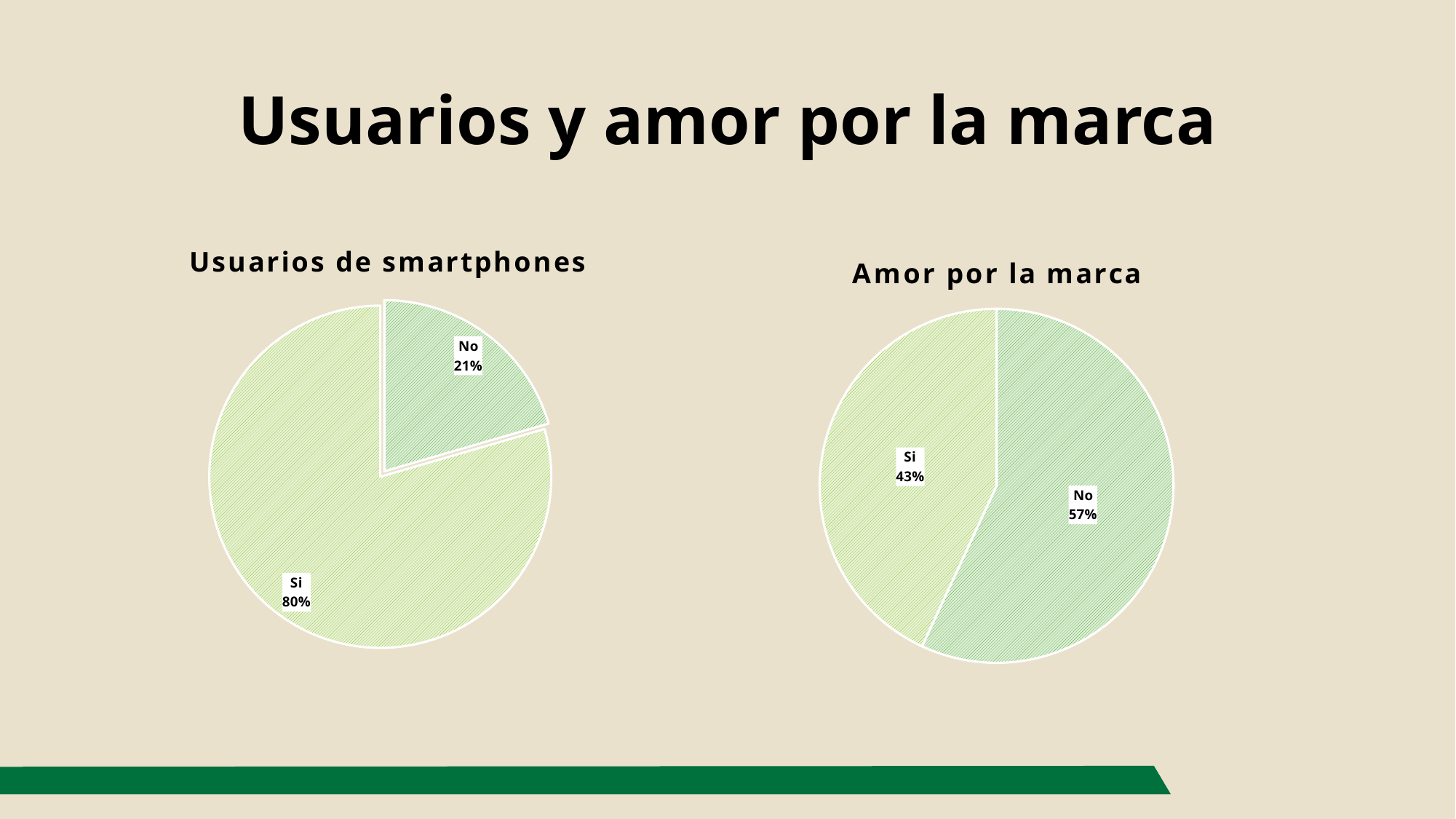
In the 'Amor por la marca' chart, what is the difference between the No and Si values? 14% What type of chart is the 'Amor por la marca' chart? Pie chart In the 'Usuarios de smartphones' chart, what is the value for Si? 80% In the 'Amor por la marca' chart, which is larger, Si or No? No What is the title of the chart on the left of the slide? Usuarios de smartphones In the 'Amor por la marca' chart, which slice is the smallest? Si In the 'Usuarios de smartphones' chart, what is the difference between the Si and No values? 59% In the 'Usuarios de smartphones' chart, what is the value for No? 21% In the 'Amor por la marca' chart, what is the value for Si? 43% In the 'Amor por la marca' chart, what is the value for No? 57% In the 'Usuarios de smartphones' chart, which slice is the largest? Si How many slices does the 'Usuarios de smartphones' chart have? 2